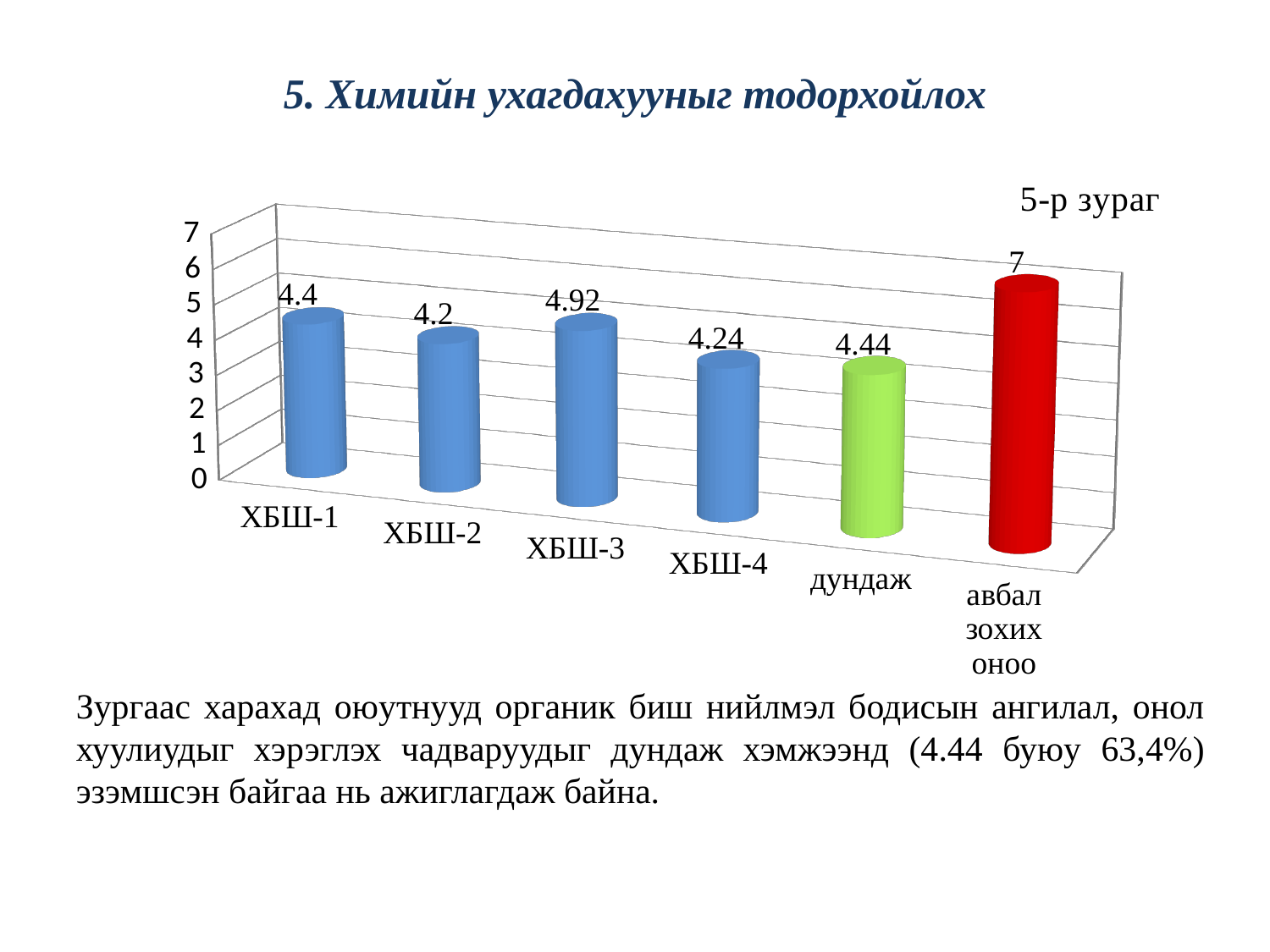
What is the value for ХБШ-1? 4.4 What is the difference between the values for ХБШ-3 and ХБШ-2? 0.72 What kind of chart is shown on the slide? bar chart What is the difference between the value for авбал зохих оноо and the value for дундаж? 2.56 What colour is the bar for авбал зохих оноо? red Which category has the highest value? авбал зохих оноо Which is larger, the value for ХБШ-1 or the value for ХБШ-4? ХБШ-1 What is the value for авбал зохих оноо? 7 What is the value for ХБШ-3? 4.92 Which category has the lowest value? ХБШ-2 What is the value for дундаж? 4.44 How many categories are shown on the chart? 6